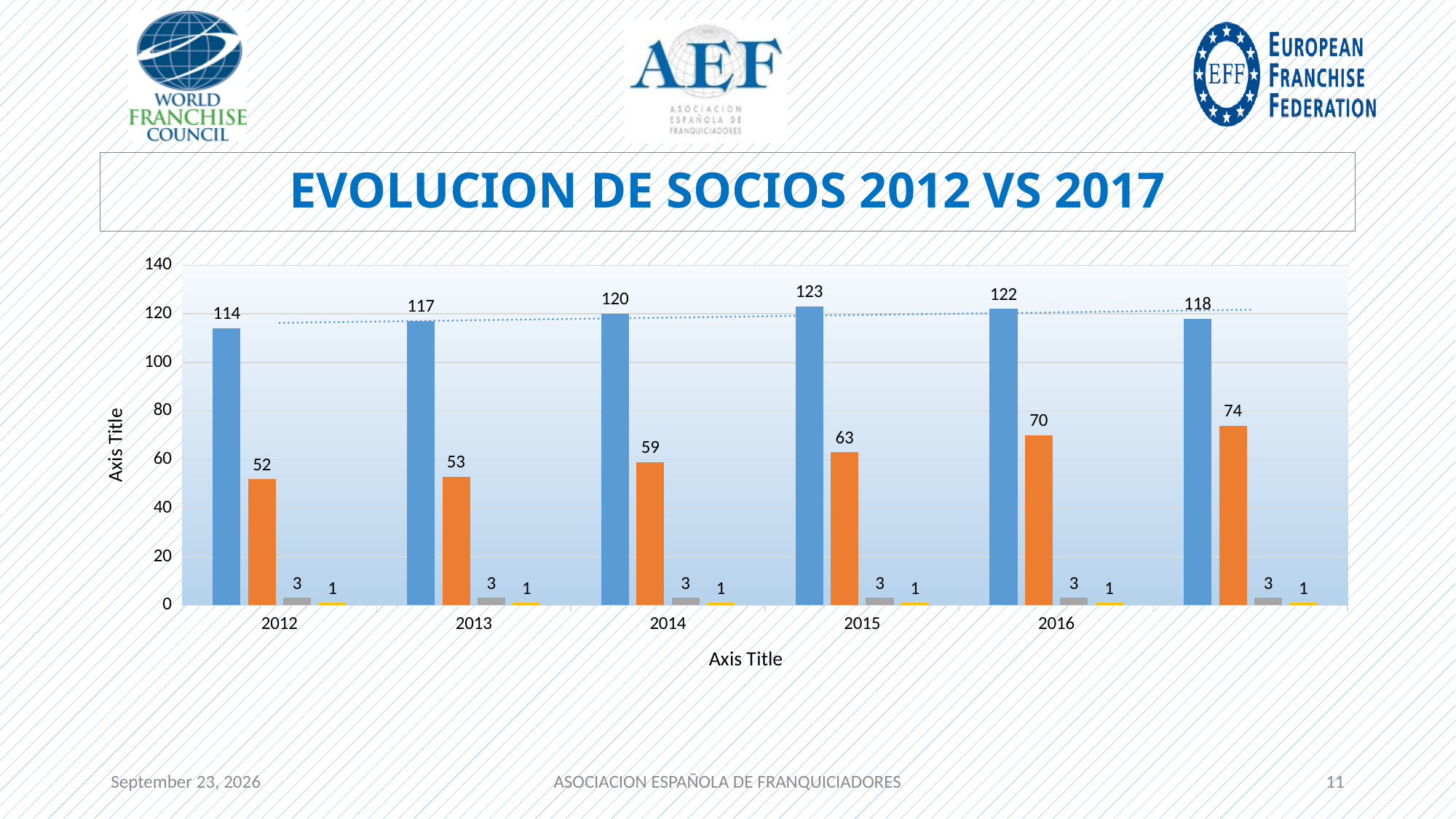
What is the title of the slide above the chart? EVOLUCION DE SOCIOS 2012 VS 2017 Which is larger, the orange bar for 2014 or the orange bar for 2013? 2014 What is the value of the gray bar for 2014? 3 Is the value of the blue bar for 2013 greater or less than 100? greater What is the difference between the blue bar for 2016 and the blue bar for 2012? 8 What is the value of the blue bar for 2012? 114 Which year has the highest blue bar? 2015 How many bars are shown in each year group? 4 What is the value of the orange bar for 2015? 63 Which year has the lowest blue bar? 2012 Do the orange bars rise or fall from 2012 to 2016? rise What kind of chart is shown on the slide? bar chart